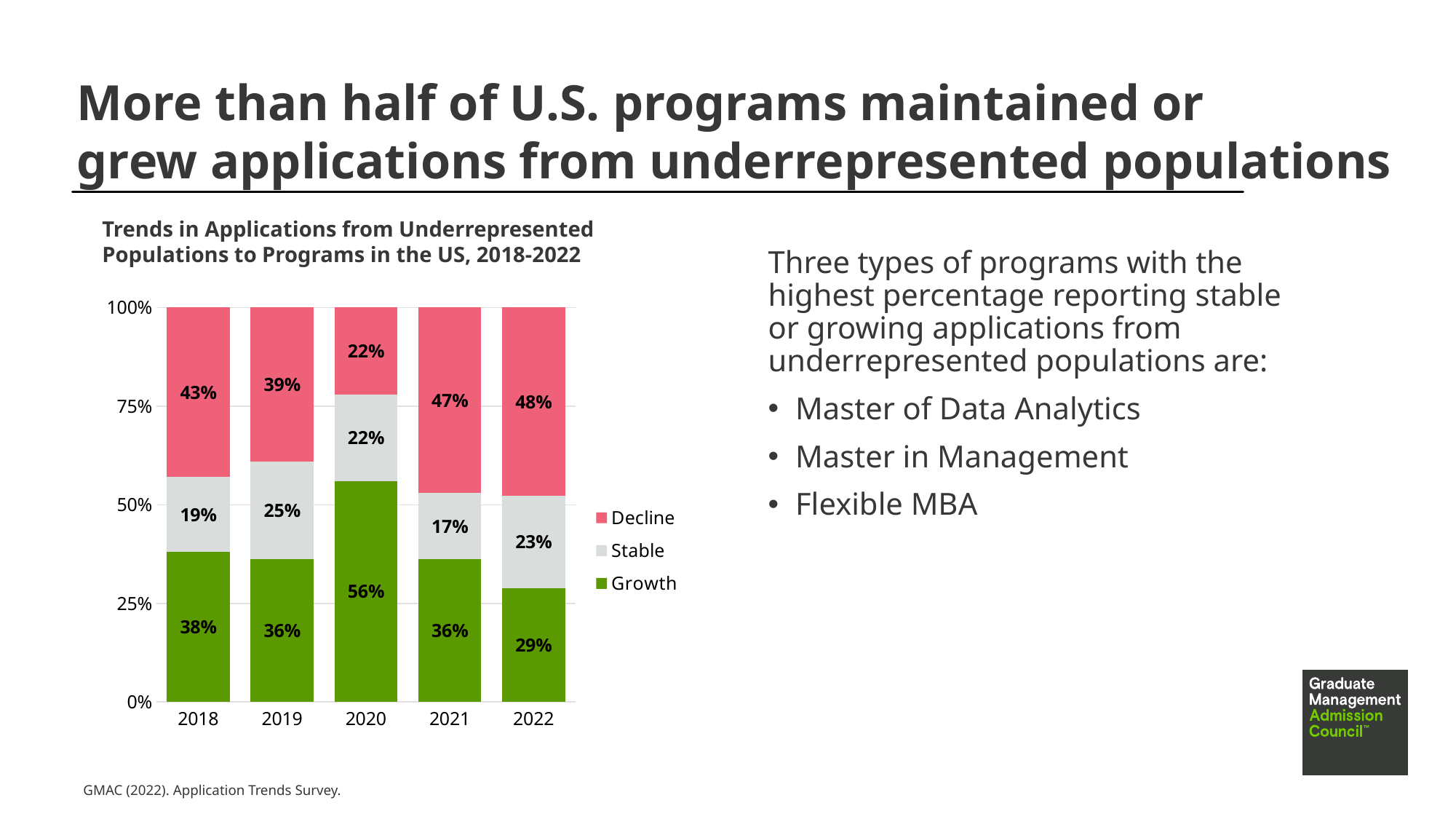
Which year has the highest Growth value? 2020 Which colour represents the Decline series in the legend? Pink What is the Decline value for 2022? 48% What is the Stable value for 2019? 25% How many series does the legend list? 3 What is the difference between the Decline values for 2022 and 2020? 26% What is the combined Growth and Stable share for 2021? 53% What is the Growth value for 2020? 56% What kind of chart is shown on the slide? Stacked bar chart How many years are shown on the x axis? 5 Which is larger, the Stable value for 2018 or the Stable value for 2022? 2022 Which year has the lowest Decline value? 2020